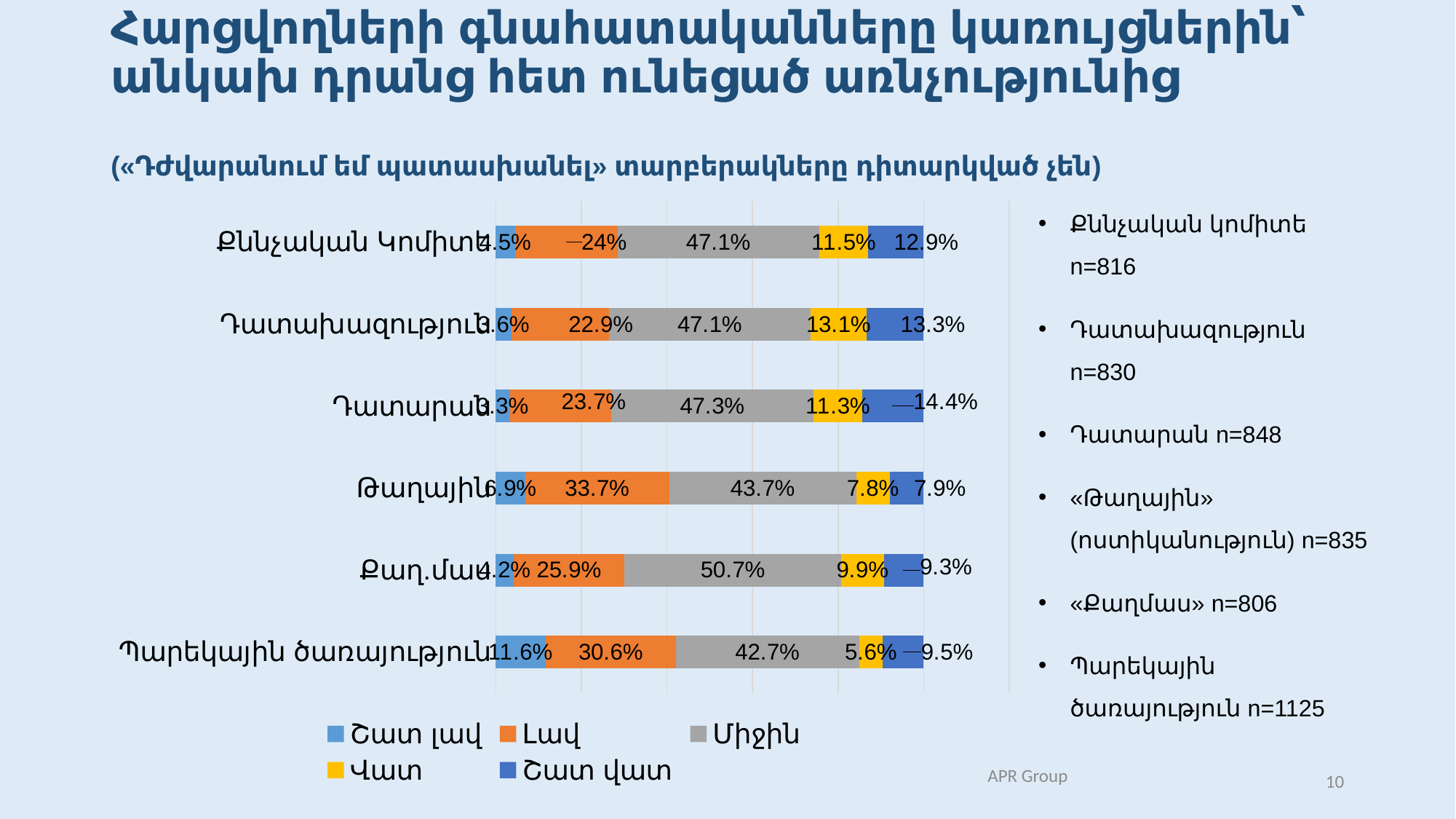
Which category has the lowest Վատ value? Պարեկային ծառայություն What is the Միջին value for Քաղ.մաս? 50.7% What is the Լավ value for Թաղային? 33.7% Which has a larger Լավ value: Պարեկային ծառայություն or Դատախազություն? Պարեկային ծառայություն What kind of chart is shown on the slide? Bar chart Which category has the highest Շատ վատ value? Դատարան Which category has the highest Միջին value? Քաղ.մաս What is the Շատ վատ value for Քննչական Կոմիտե? 12.9% What colour represents the Միջին series in the chart? Gray How many series does the legend list? 5 What is the difference between the Շատ վատ values for Դատարան and Թաղային? 6.5 percentage points How many categories (institutions) are plotted on the chart? 6